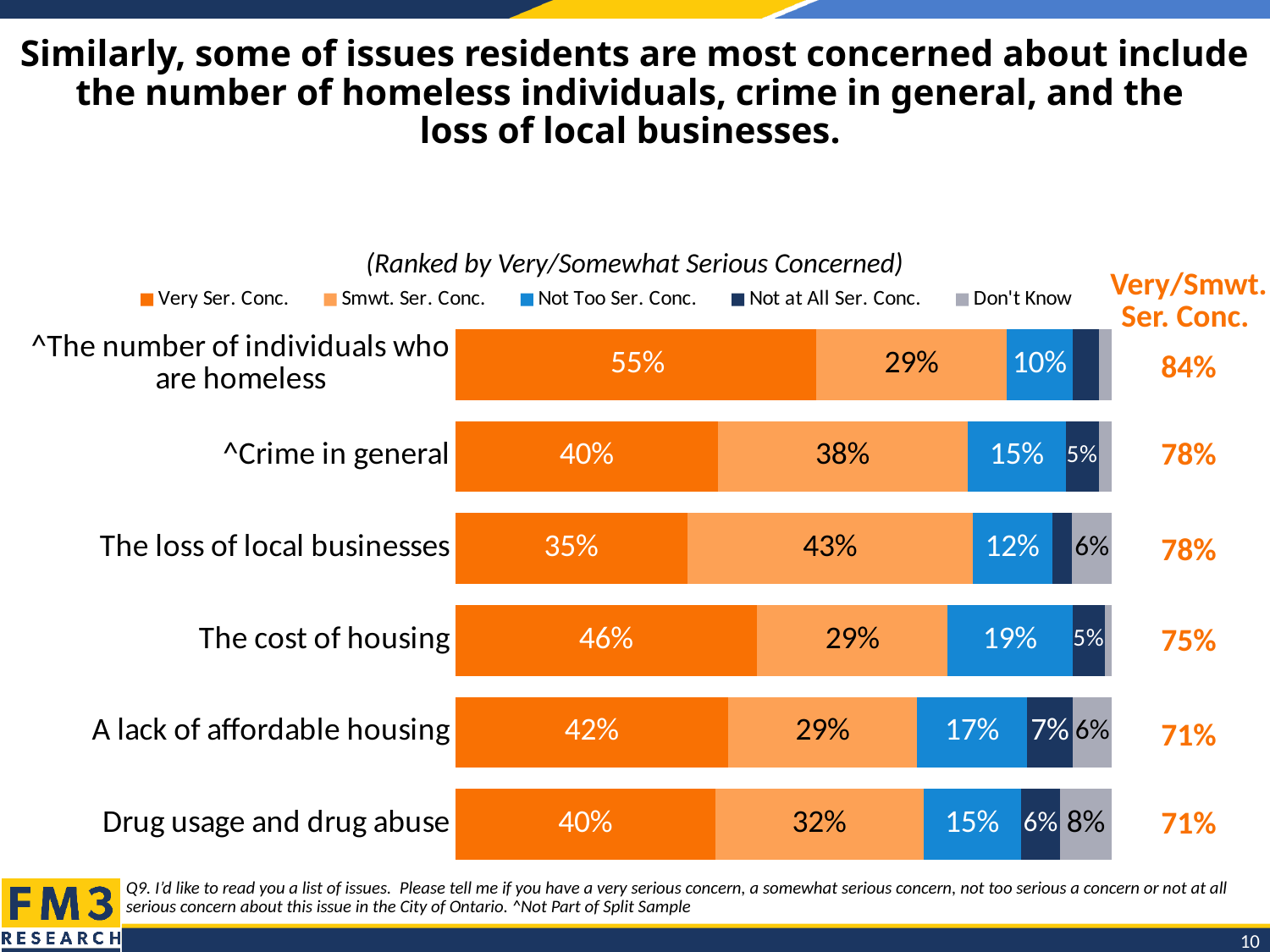
Which issue has the highest Very Ser. Conc. value? The number of individuals who are homeless Which is larger: the Smwt. Ser. Conc. value for crime in general or for drug usage and drug abuse? Crime in general Which issue has the lowest Very Ser. Conc. value? The loss of local businesses What is the Very/Smwt. Ser. Conc. total shown for crime in general? 78% According to the subtitle, how are the issues in the chart ranked? By Very/Somewhat Serious Concerned How many series does the legend list? 5 What is the Smwt. Ser. Conc. value for the loss of local businesses? 43% What kind of chart is shown on the slide? Stacked bar chart What is the Not Too Ser. Conc. value for the cost of housing? 19% How many issues are listed in the chart? 6 What percentage of residents have a very serious concern about the number of individuals who are homeless? 55% What is the difference between the Very Ser. Conc. values for the number of individuals who are homeless and crime in general? 15 percentage points